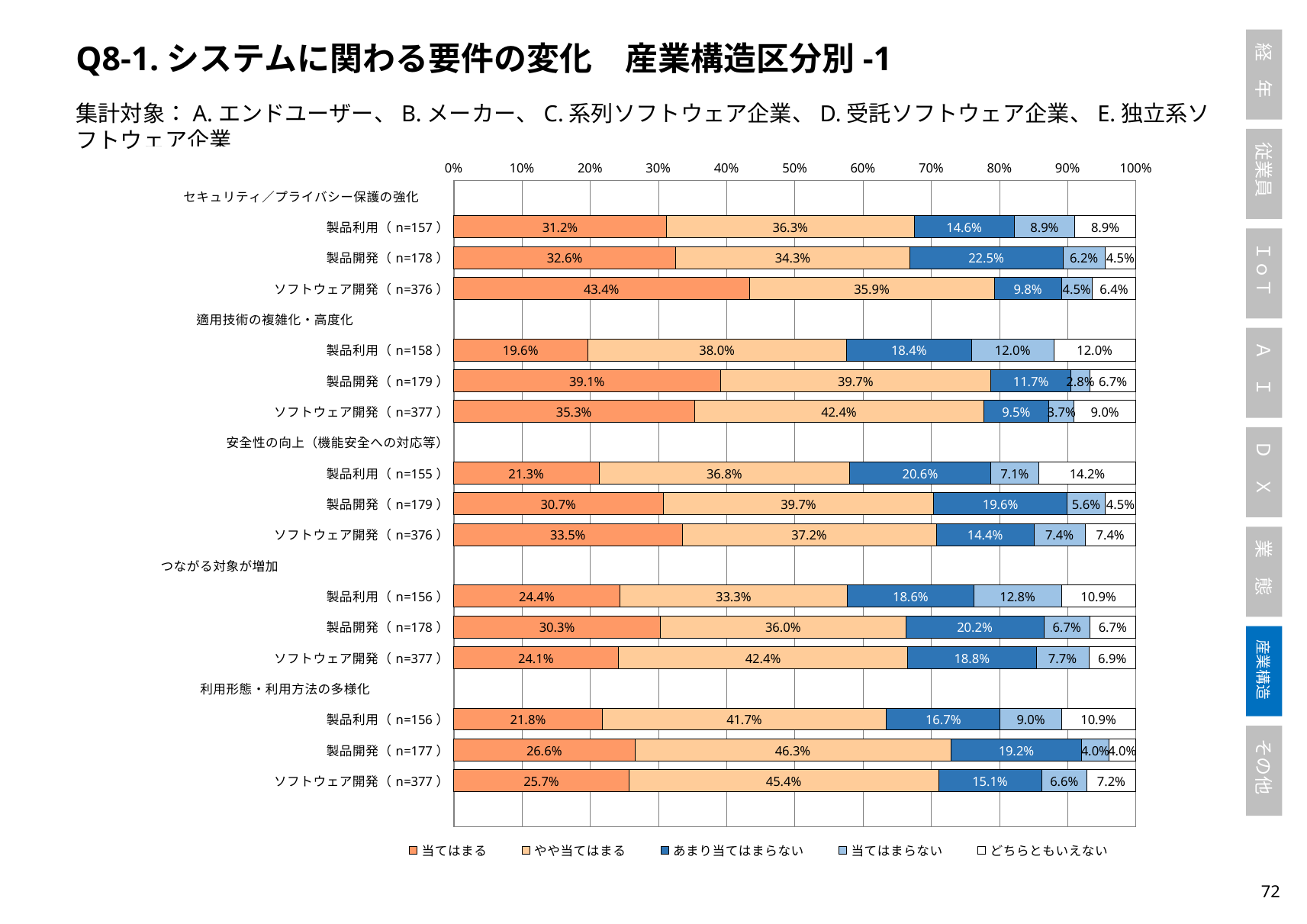
What is the どちらともいえない value for 製品利用 (n=158) under 適用技術の複雑化・高度化? 12.0% Which bar has the highest 当てはまる value? ソフトウェア開発 (n=376) under セキュリティ／プライバシー保護の強化 What is the difference in 当てはまる between ソフトウェア開発 (n=376) and 製品利用 (n=157) under セキュリティ／プライバシー保護の強化? 12.2 percentage points What is the 当てはまる value for ソフトウェア開発 (n=376) under セキュリティ／プライバシー保護の強化? 43.4% Under つながる対象が増加, which has the larger やや当てはまる value: 製品開発 (n=178) or ソフトウェア開発 (n=377)? ソフトウェア開発 (n=377) What is the やや当てはまる value for 製品開発 (n=177) under 利用形態・利用方法の多様化? 46.3% Which bar has the lowest 当てはまる value? 製品利用 (n=158) under 適用技術の複雑化・高度化 How many bars (respondent rows) are plotted in the chart? 15 What is the あまり当てはまらない value for 製品利用 (n=155) under 安全性の向上（機能安全への対応等）? 20.6% What type of chart is shown on the slide? Stacked horizontal bar chart How many series does the legend list? 5 Which legend entry is shown in the darkest blue colour? あまり当てはまらない